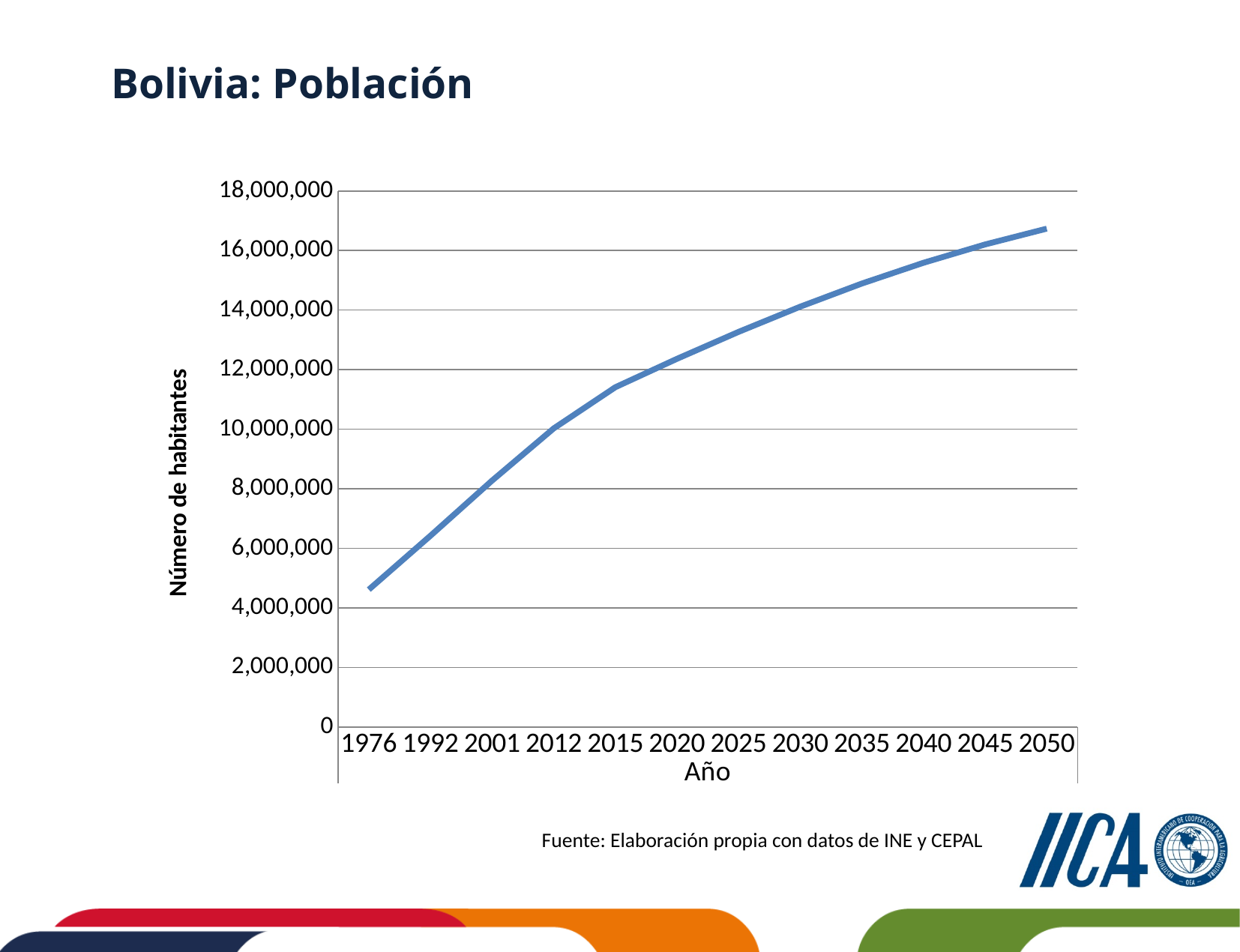
Is the value for 2050 greater or less than 16,000,000? greater Which year has the highest population value? 2050 What is the label of the y axis? Número de habitantes Does the population rise or fall from 1976 to 2050? rise Is the value for 1976 greater or less than 6,000,000? less Is the value for 2035 greater or less than 16,000,000? less What kind of chart is shown on the slide? line chart Which year has the lowest population value? 1976 How many years are plotted along the x axis? 12 Which is larger, the value for 2001 or the value for 2025? 2025